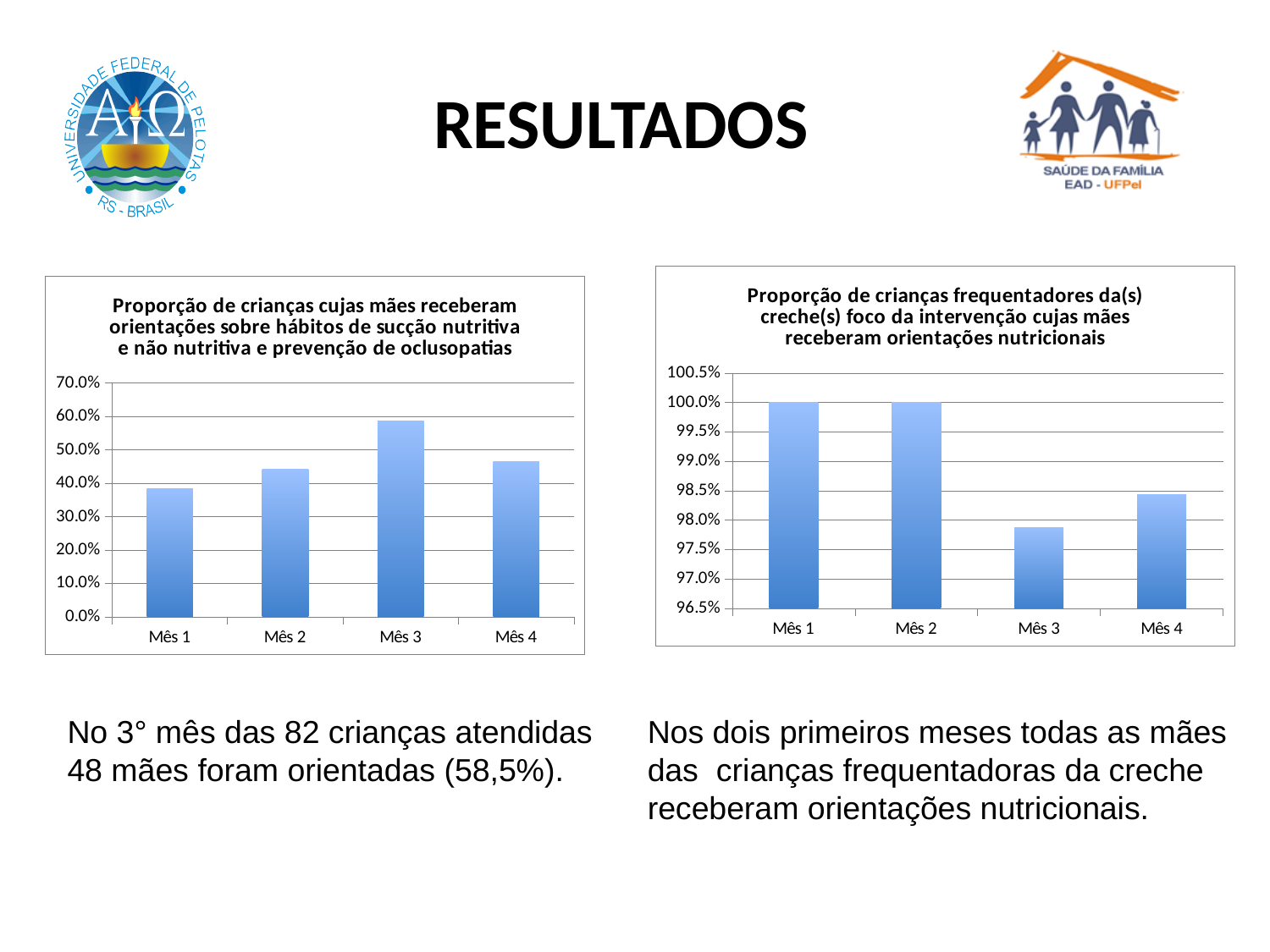
In the right chart (orientações nutricionais), is the value for Mês 4 greater or less than 98.0%? greater In the left chart (orientações sobre hábitos de sucção), is the value for Mês 3 greater or less than 50.0%? greater In the left chart (orientações sobre hábitos de sucção), which month has the highest value? Mês 3 In the right chart (orientações nutricionais), which month has the lowest value? Mês 3 How many months are plotted in the left chart (orientações sobre hábitos de sucção)? 4 What is the highest value shown on the y-axis of the left chart (orientações sobre hábitos de sucção)? 70.0% What kind of chart is the left chart, 'Proporção de crianças cujas mães receberam orientações sobre hábitos de sucção nutritiva e não nutritiva e prevenção de oclusopatias'? Bar chart In the left chart (orientações sobre hábitos de sucção), is the value for Mês 1 greater or less than 40.0%? less In the left chart (orientações sobre hábitos de sucção), which is larger, the value for Mês 1 or Mês 2? Mês 2 In the left chart (orientações sobre hábitos de sucção), which month has the lowest value? Mês 1 In the right chart (orientações nutricionais), what is the value for Mês 2? 100.0% In the right chart (orientações nutricionais), what is the value for Mês 1? 100.0%